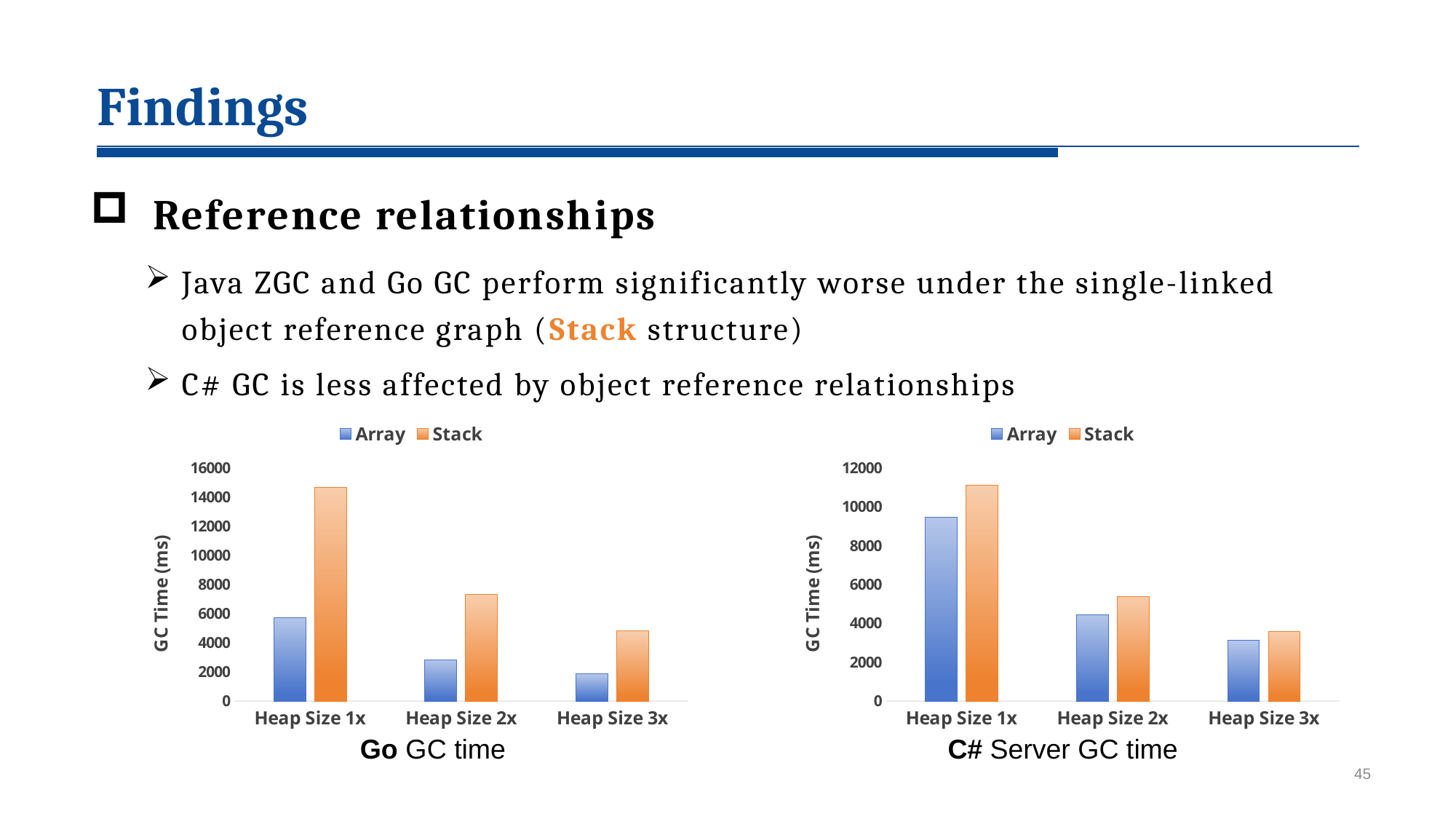
In the Go GC time chart, does the Array GC time rise or fall as heap size increases from 1x to 3x? fall In the Go GC time chart, is the Stack value for Heap Size 1x greater or less than 12000? greater In the Go GC time chart, is the Stack value for Heap Size 2x greater or less than 6000? greater In the C# Server GC time chart, is the Stack value for Heap Size 1x greater or less than 10000? greater In the C# Server GC time chart, how many series does the legend list? 2 In the Go GC time chart, which heap size has the highest Stack GC time? Heap Size 1x What kind of chart is the Go GC time chart? bar chart In the C# Server GC time chart, which heap size has the lowest Array GC time? Heap Size 3x